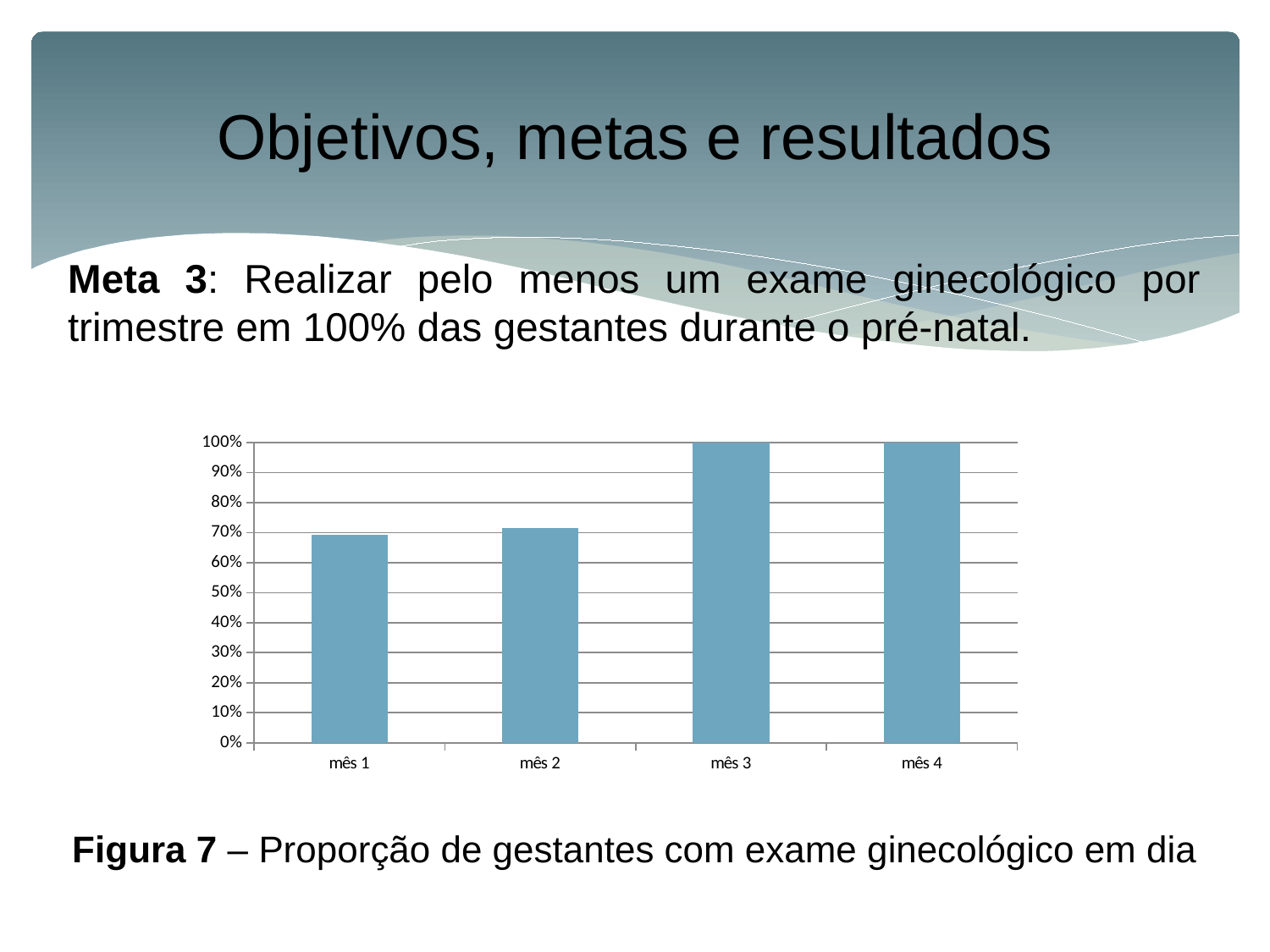
Which is larger, the value for mês 2 or the value for mês 4? mês 4 Which is larger, the value for mês 1 or the value for mês 3? mês 3 Is the value for mês 1 greater or less than 80%? less How many categories (months) are shown on the x axis of the chart? 4 What is the value for mês 4? 100% Is the value for mês 2 greater or less than 80%? less What is the value for mês 3? 100% What is the figure caption given below the chart? Figura 7 – Proporção de gestantes com exame ginecológico em dia Do the values generally rise or fall from mês 1 to mês 4? rise Is the value for mês 1 greater or less than 60%? greater What kind of chart is shown on the slide? bar chart